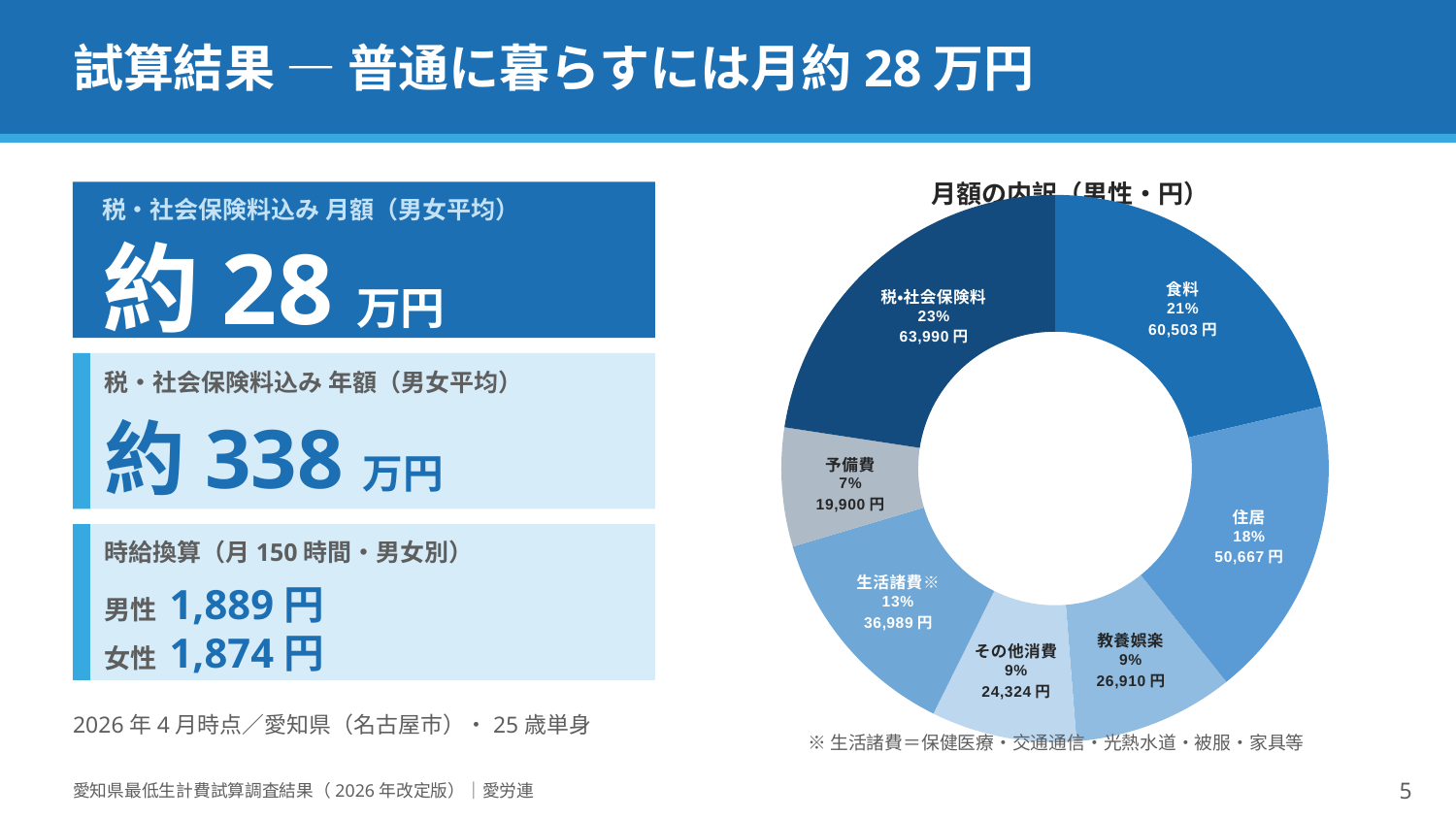
What type of chart is shown on the slide? Donut (pie) chart What is the monthly amount for 住居 in the chart? 50,667 円 What is the title of the chart? 月額の内訳（男性・円） What percentage share does 生活諸費 have in the chart? 13% How many categories does the donut chart show? 7 Which is larger in yen, 教養娯楽 or その他消費? 教養娯楽 What is the monthly amount for 予備費 in the chart? 19,900 円 What percentage share does 税・社会保険料 have in the chart? 23% What is the difference in yen between 税・社会保険料 and 食料? 3,487 円 Which category has the largest share in the chart? 税・社会保険料 Which category has the smallest share in the chart? 予備費 What is the monthly amount for 食料 in the chart? 60,503 円